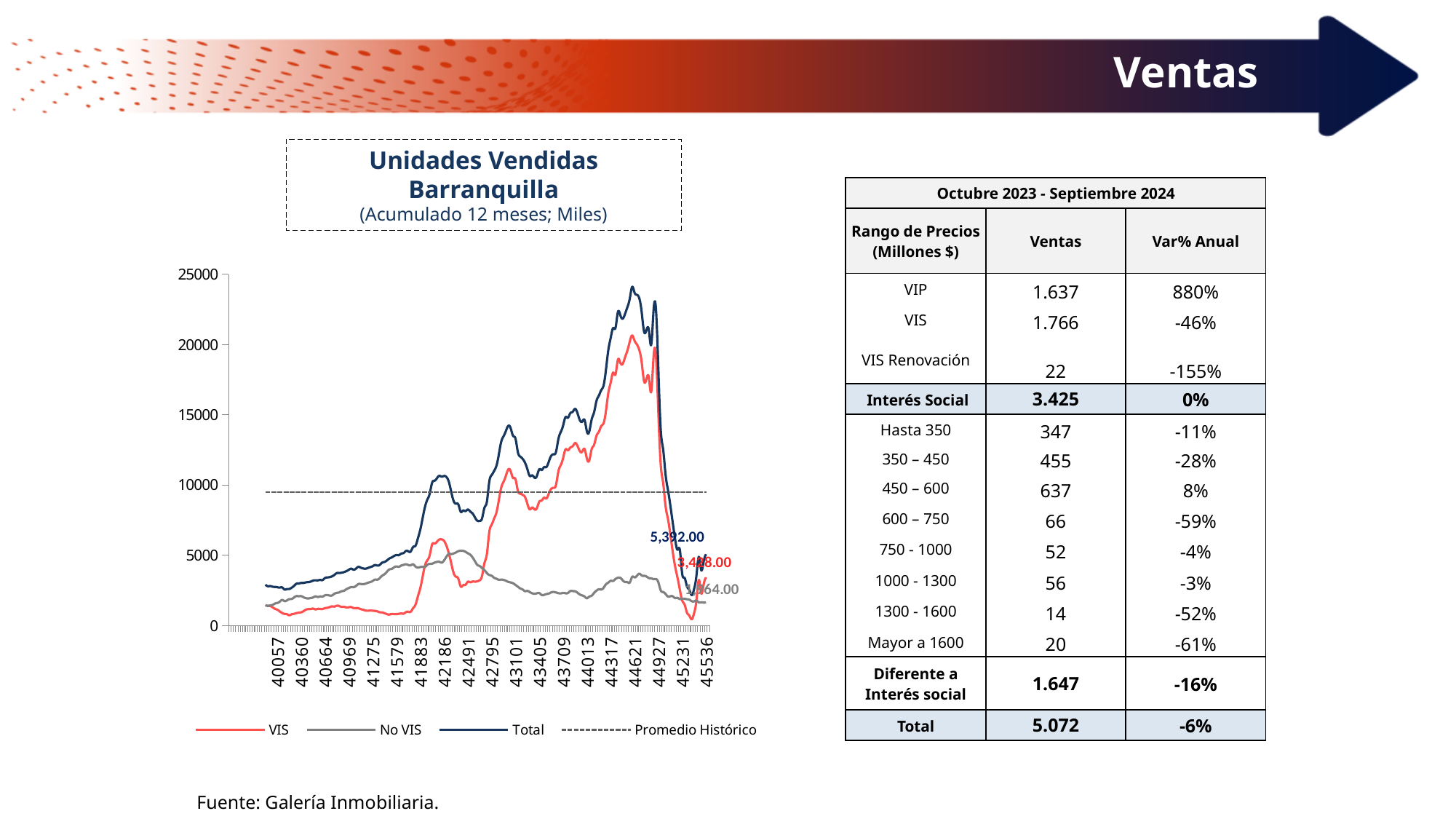
How many series does the legend of the "Unidades Vendidas Barranquilla" chart list? 4 In the "Unidades Vendidas Barranquilla" chart, which series reaches the highest peak? Total What is the final data label shown for the Total series in the "Unidades Vendidas Barranquilla" chart? 5,392.00 In the "Unidades Vendidas Barranquilla" chart, is the peak of the No VIS series greater or less than 10000? less What kind of chart is shown under the title "Unidades Vendidas Barranquilla"? Line chart In the "Unidades Vendidas Barranquilla" chart, is the Promedio Histórico line greater or less than 5000? greater In the "Unidades Vendidas Barranquilla" chart, which series is drawn as a dashed line? Promedio Histórico In the "Unidades Vendidas Barranquilla" chart, is the peak of the VIS series greater or less than 15000? greater How many labels are shown on the x axis of the "Unidades Vendidas Barranquilla" chart? 19 In the "Unidades Vendidas Barranquilla" chart, does the Total series rise or fall between the x-axis labels 44621 and 45231? fall What is the subtitle shown in parentheses under the chart title "Unidades Vendidas Barranquilla"? (Acumulado 12 meses; Miles)